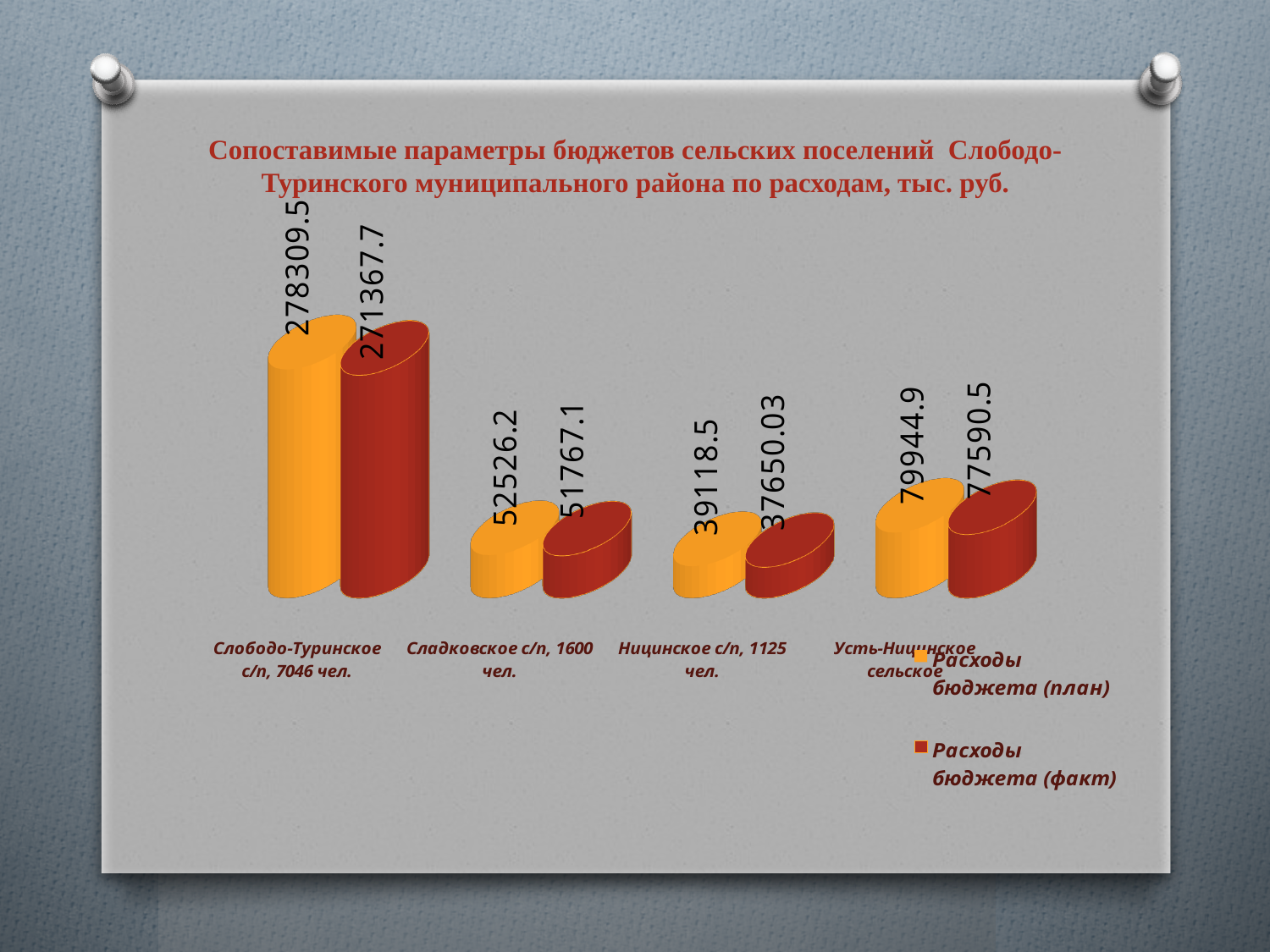
What is the difference between the planned and actual budget expenditure for Усть-Ницинское сельское? 2354.4 How many settlements (categories) are shown on the chart? 4 Which is larger for Сладковское с/п: the planned or the actual budget expenditure? Planned (план) What is the planned budget expenditure (Расходы бюджета (план)) for Слободо-Туринское с/п? 278309.5 What is the actual budget expenditure (Расходы бюджета (факт)) for Ницинское с/п? 37650.03 What is the planned budget expenditure (план) for Усть-Ницинское сельское? 79944.9 Which settlement has the highest planned budget expenditure? Слободо-Туринское с/п What is the difference between the planned and actual budget expenditure for Слободо-Туринское с/п? 6941.8 How many series does the legend list? 2 What is the actual budget expenditure (факт) for Сладковское с/п? 51767.1 Which settlement has the lowest actual budget expenditure? Ницинское с/п What type of chart is shown on the slide? Bar chart